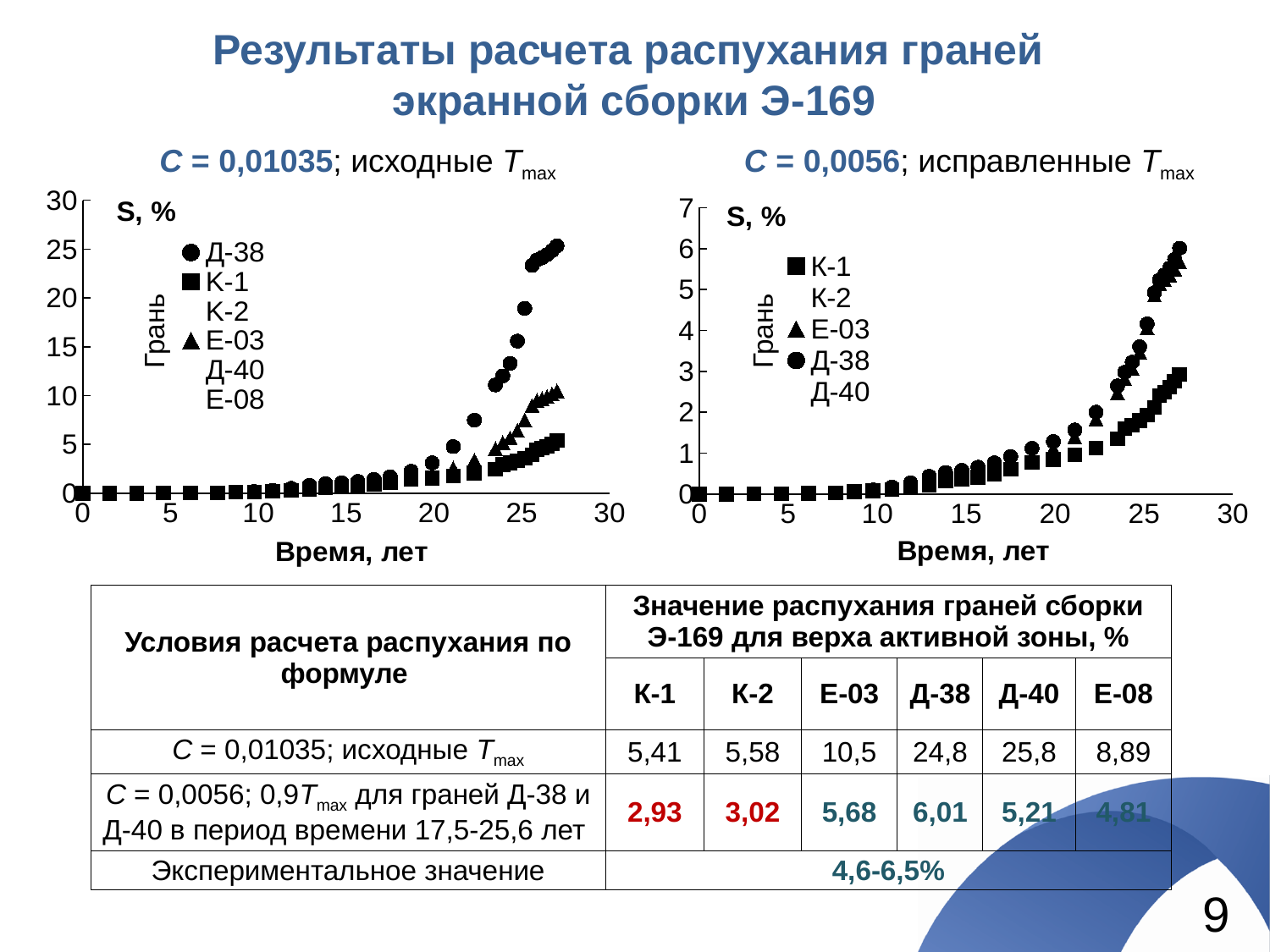
What kind of chart is the left chart (C = 0,01035; исходные Tmax)? scatter chart In the left chart (C = 0,01035; исходные Tmax), which reaches a higher value at the end of the time range, Д-38 or К-1? Д-38 In the left chart (C = 0,01035; исходные Tmax), is the highest value for Е-03 greater or less than 15? less What is the label of the x axis on the right chart (C = 0,0056; исправленные Tmax)? Время, лет What is the maximum value shown on the y axis of the right chart (C = 0,0056; исправленные Tmax)? 7 In the right chart (C = 0,0056; исправленные Tmax), is the highest value for К-1 greater or less than 4? less In the left chart (C = 0,01035; исходные Tmax), do the values for Д-38 rise or fall as time increases? rise How many series does the legend of the left chart (C = 0,01035; исходные Tmax) list? 6 In the left chart (C = 0,01035; исходные Tmax), is the highest value for Д-38 greater or less than 20? greater How many series does the legend of the right chart (C = 0,0056; исправленные Tmax) list? 5 In the right chart (C = 0,0056; исправленные Tmax), do the values for К-1 rise or fall as time increases? rise